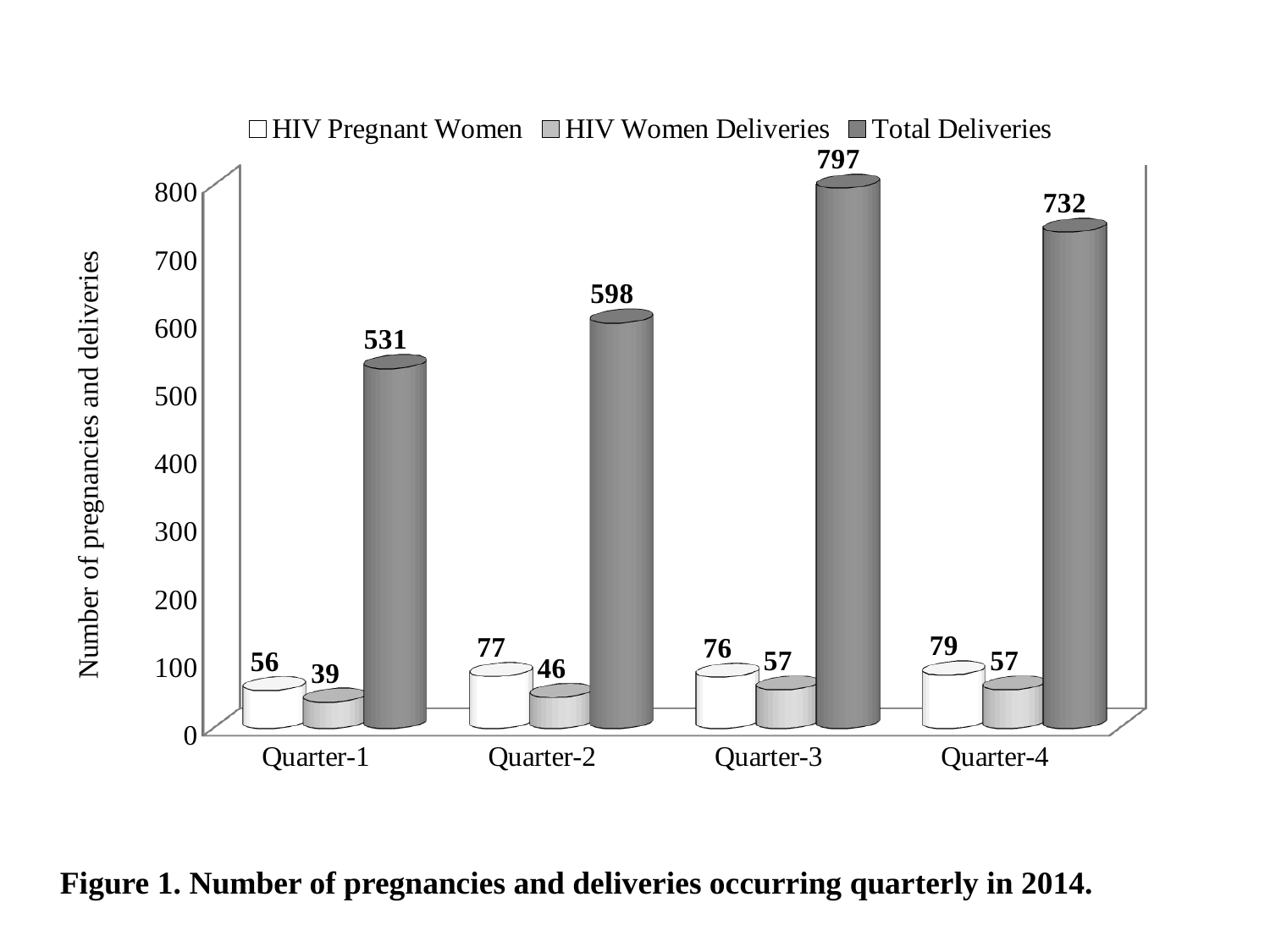
What is the value for HIV Women Deliveries in Quarter-2? 46 Is the value for Total Deliveries in Quarter-2 greater or less than 500? greater Which quarter has the lowest value for HIV Women Deliveries? Quarter-1 What is the y-axis label of the chart? Number of pregnancies and deliveries What kind of chart is shown? bar chart What is the value for HIV Pregnant Women in Quarter-1? 56 How many quarters are shown on the x axis? 4 Which is larger: HIV Pregnant Women in Quarter-2 or in Quarter-1? Quarter-2 How many series does the legend list? 3 What is the difference between Total Deliveries in Quarter-3 and Quarter-1? 266 What is the value for Total Deliveries in Quarter-3? 797 Which quarter has the highest Total Deliveries? Quarter-3